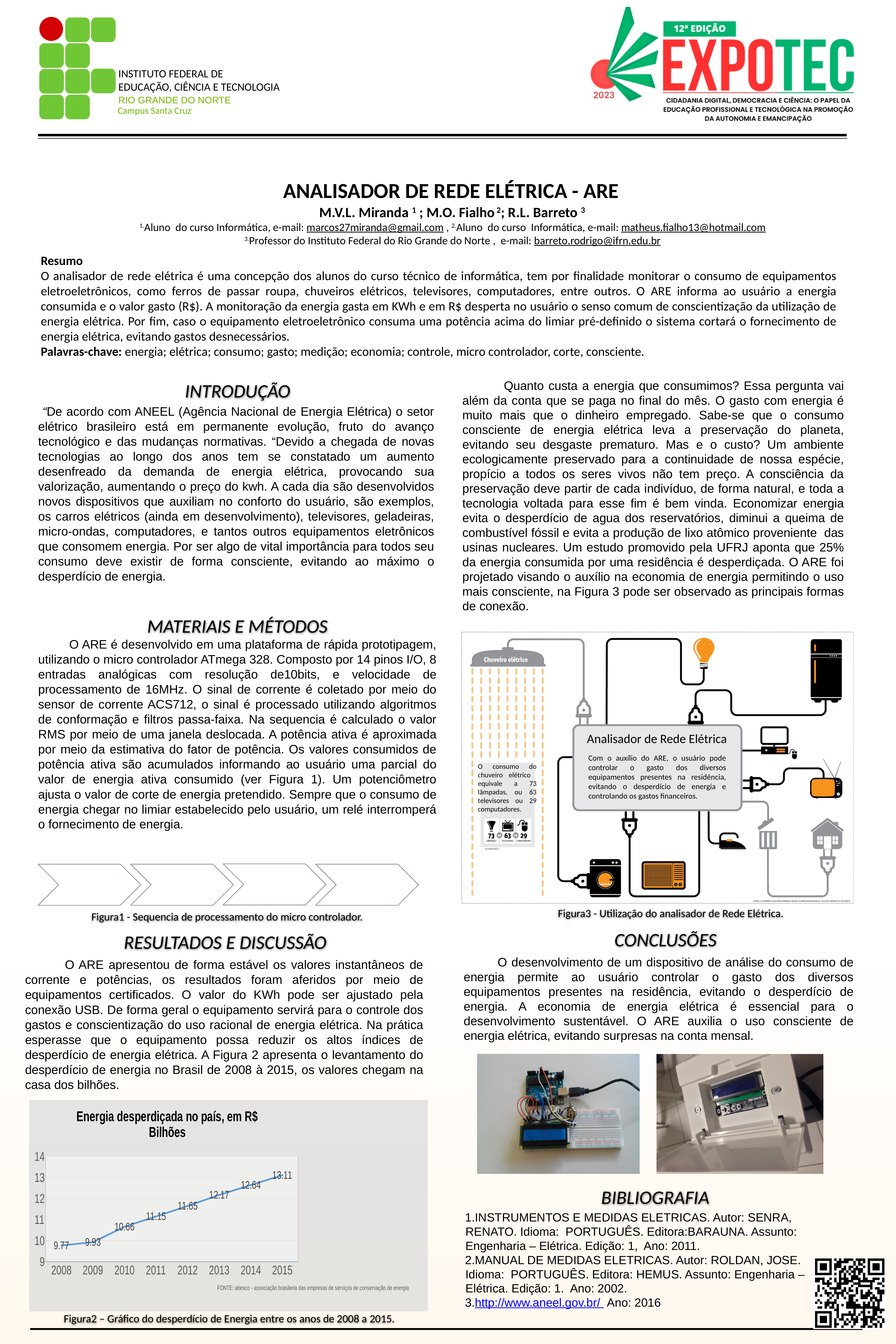
In the chart 'Energia desperdiçada no país, em R$ Bilhões', what is the difference between the values for 2015 and 2008? 3.34 In the chart 'Energia desperdiçada no país, em R$ Bilhões', what is the value for 2012? 11.65 In the chart 'Energia desperdiçada no país, em R$ Bilhões', do the values rise or fall from 2008 to 2015? rise In the chart 'Energia desperdiçada no país, em R$ Bilhões', what is the value for 2015? 13.11 In the chart 'Energia desperdiçada no país, em R$ Bilhões', which year has the highest value? 2015 How many years are plotted in the chart 'Energia desperdiçada no país, em R$ Bilhões'? 8 In the chart 'Energia desperdiçada no país, em R$ Bilhões', which is larger, the value for 2010 or the value for 2013? 2013 What is the title of the chart in Figura 2? Energia desperdiçada no país, em R$ Bilhões What type of chart is shown in Figura 2, 'Energia desperdiçada no país, em R$ Bilhões'? line chart In the chart 'Energia desperdiçada no país, em R$ Bilhões', is the value for 2011 greater or less than 12? less In the chart 'Energia desperdiçada no país, em R$ Bilhões', which year has the lowest value? 2008 In the chart 'Energia desperdiçada no país, em R$ Bilhões', what is the value for 2008? 9.77